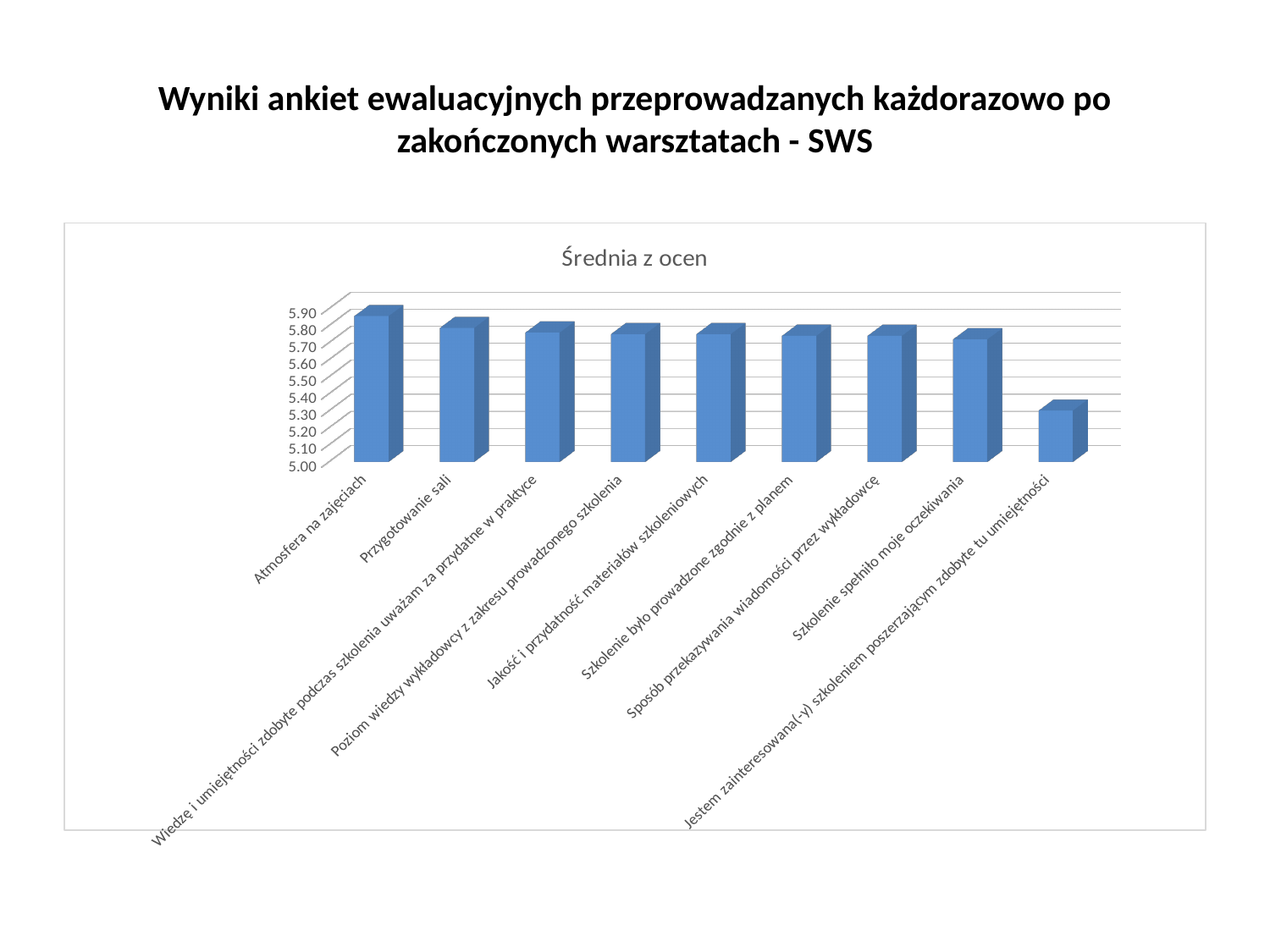
Is the value for Szkolenie spełniło moje oczekiwania greater or less than 5.40? greater What colour are the bars in the chart? blue What is the title of the chart? Średnia z ocen Is the value for Atmosfera na zajęciach greater or less than 5.70? greater Is the value for Jestem zainteresowana(-y) szkoleniem poszerzającym zdobyte tu umiejętności greater or less than 5.50? less How many categories are plotted in the chart? 9 Which category has the highest value? Atmosfera na zajęciach Which is larger: the value for Przygotowanie sali or the value for Jestem zainteresowana(-y) szkoleniem poszerzającym zdobyte tu umiejętności? Przygotowanie sali Which is larger: the value for Atmosfera na zajęciach or the value for Jestem zainteresowana(-y) szkoleniem poszerzającym zdobyte tu umiejętności? Atmosfera na zajęciach Which category has the lowest value? Jestem zainteresowana(-y) szkoleniem poszerzającym zdobyte tu umiejętności What kind of chart is shown on the slide? bar chart